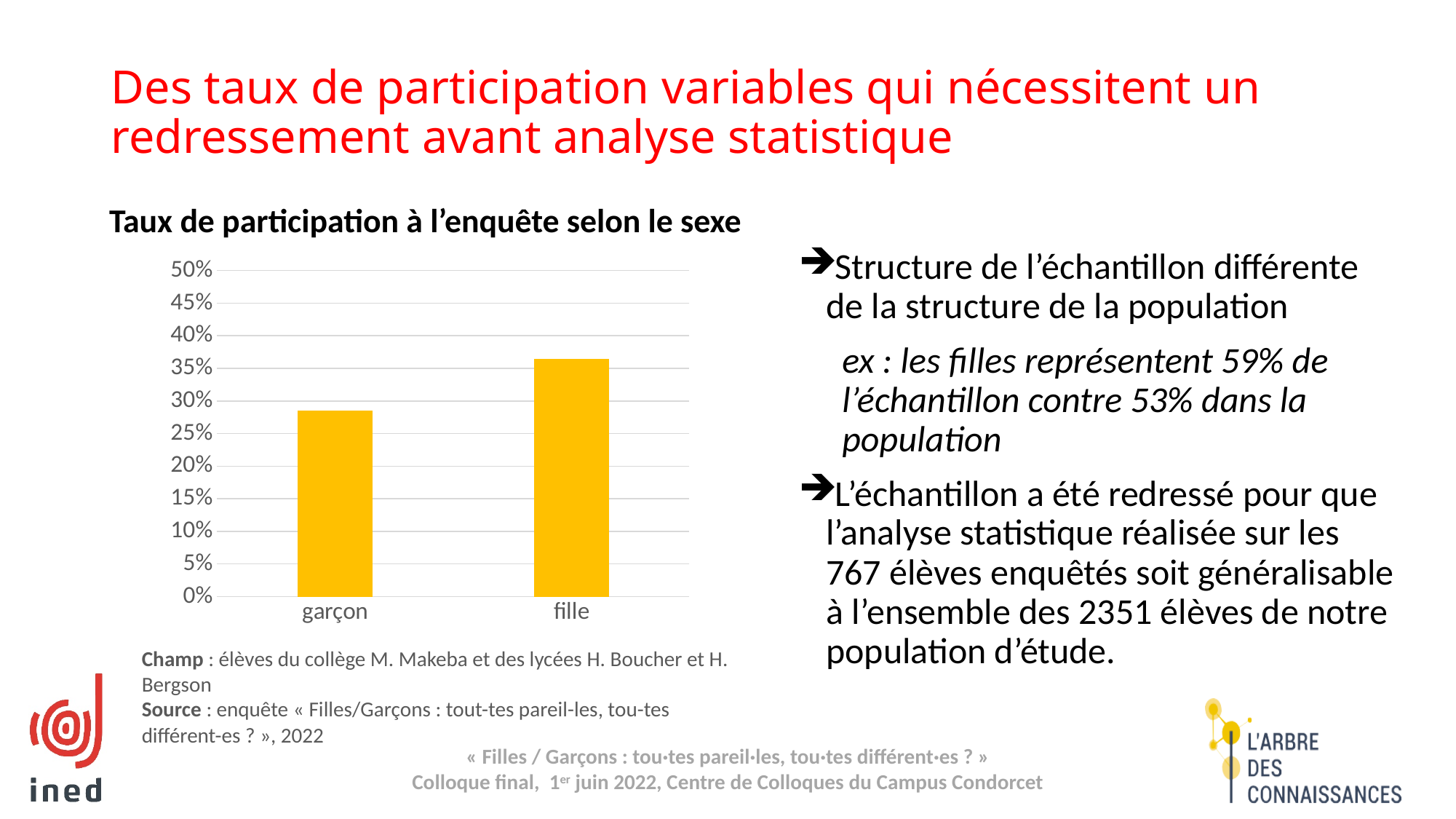
What kind of chart is shown on the slide? bar chart Is the value for fille greater or less than 35%? greater Which category has the highest participation rate? fille Do the values rise or fall from garçon to fille along the x axis? rise What is the highest value shown on the chart's y axis? 50% Is the value for fille greater or less than 40%? less How many categories are shown on the x axis of the chart? 2 Is the value for garçon greater or less than 25%? greater Which category has the lowest participation rate? garçon What is the title of the chart? Taux de participation à l'enquête selon le sexe Which is larger, the participation rate for garçon or for fille? fille